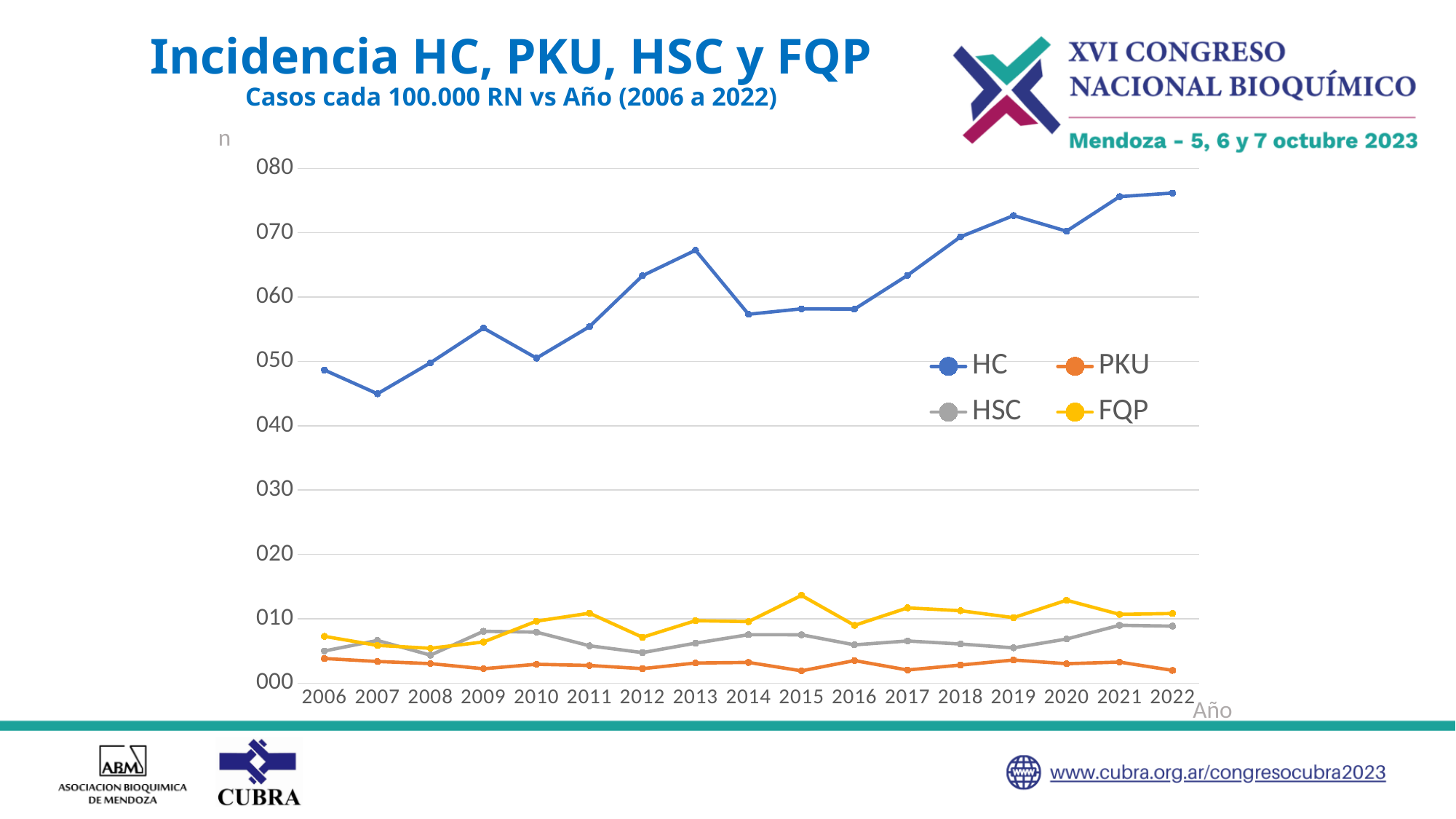
Does the HC series generally rise or fall from 2006 to 2022? rise What kind of chart is shown on the slide? line chart Is the FQP value for 2015 greater or less than 10? greater How many series does the legend list? 4 In which year does the HC series have its lowest value? 2007 In which year does the HC series reach its highest value? 2022 Is the HC value for 2021 greater or less than 70? greater Which series has the larger value in 2015, FQP or PKU? FQP Which series is drawn in blue in the legend? HC Is the HC value for 2006 greater or less than 50? less How many years are plotted along the x axis? 17